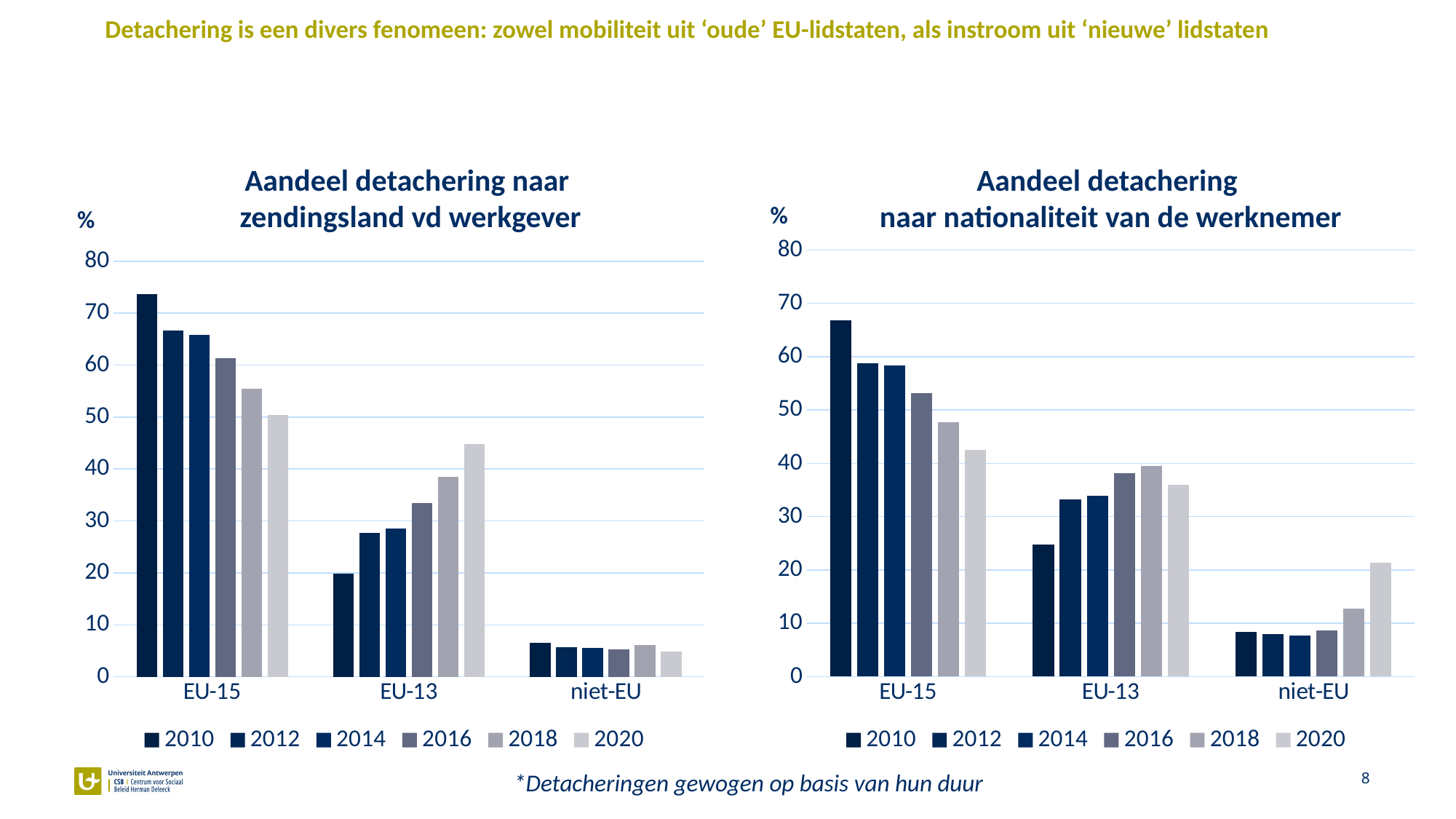
In the left chart, 'Aandeel detachering naar zendingsland vd werkgever', is the value for EU-13 in 2020 greater or less than 40? greater In the right chart, 'Aandeel detachering naar nationaliteit van de werknemer', is the value for niet-EU in 2020 greater or less than 20? greater In the left chart, 'Aandeel detachering naar zendingsland vd werkgever', which category has the highest value in 2010? EU-15 In the right chart, 'Aandeel detachering naar nationaliteit van de werknemer', is the value for EU-15 in 2010 greater or less than 60? greater In the left chart, 'Aandeel detachering naar zendingsland vd werkgever', how many series does the legend list? 6 In the left chart, 'Aandeel detachering naar zendingsland vd werkgever', how many categories are shown on the x axis? 3 In the right chart, 'Aandeel detachering naar nationaliteit van de werknemer', do the niet-EU values rise or fall from 2010 to 2020? rise In the right chart, 'Aandeel detachering naar nationaliteit van de werknemer', which category has the lowest value in 2010? niet-EU What kind of chart is the left chart, 'Aandeel detachering naar zendingsland vd werkgever'? bar chart In the left chart, 'Aandeel detachering naar zendingsland vd werkgever', do the EU-15 values rise or fall from 2010 to 2020? fall In the right chart, 'Aandeel detachering naar nationaliteit van de werknemer', which is larger in 2020: EU-15 or EU-13? EU-15